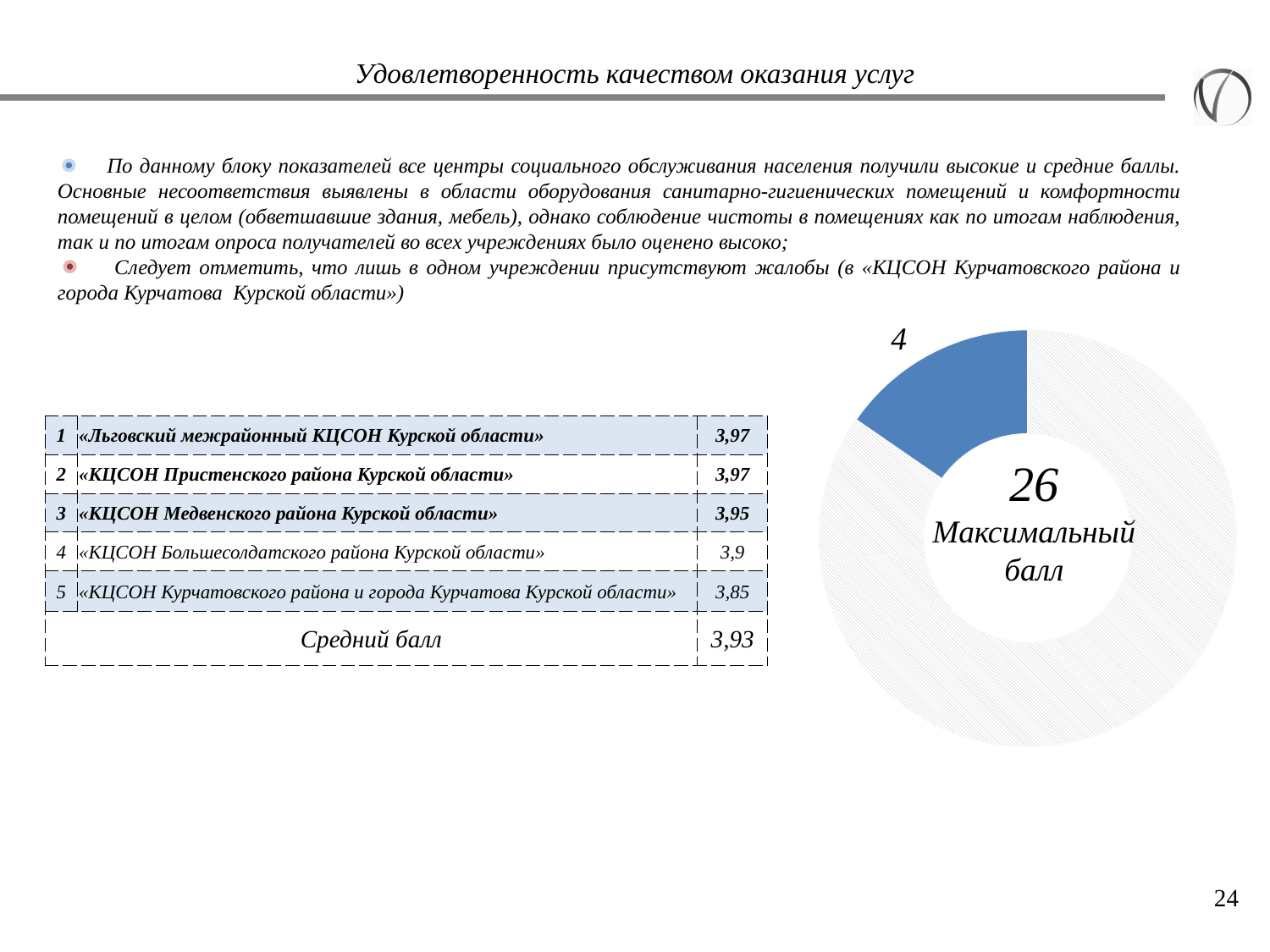
What kind of chart is shown on the right side of the slide? doughnut chart Which slice of the doughnut chart is larger, the blue slice or the hatched white slice? the hatched white slice What colour is the slice labelled 4 in the doughnut chart? blue Does the blue slice cover more or less than half of the doughnut chart? less What value is printed on the blue slice of the doughnut chart? 4 What maximum score (Максимальный балл) is shown in the centre of the doughnut chart? 26 What text is written in the centre of the doughnut chart? 26 Максимальный балл